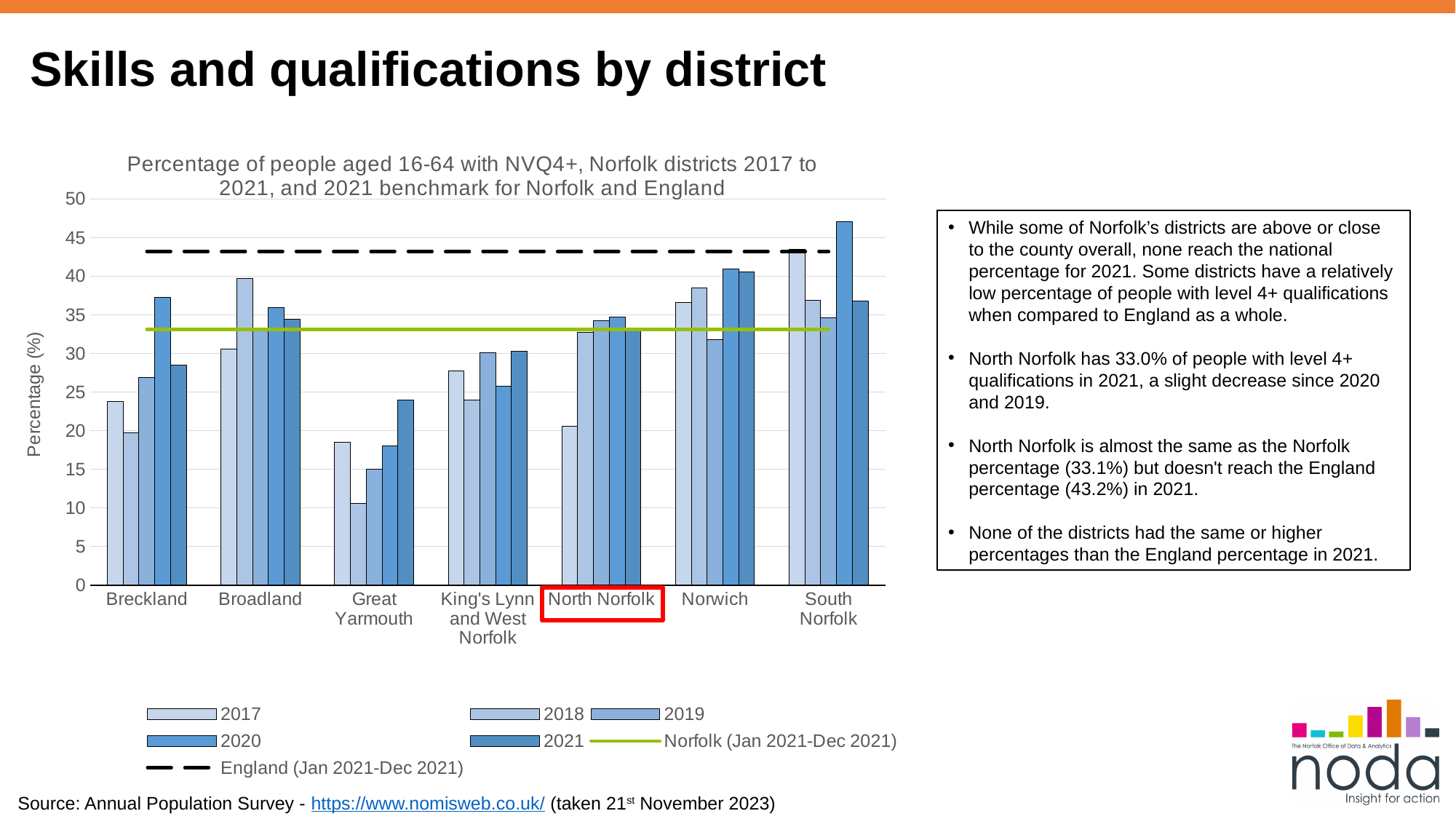
Which district has the highest single bar in the chart? South Norfolk What does the solid green horizontal line in the chart represent? Norfolk (Jan 2021-Dec 2021) Which is larger, the 2018 value for Broadland or the 2018 value for Great Yarmouth? Broadland What kind of chart is shown on the slide? Combination bar and line chart (bars for each year with horizontal benchmark lines for Norfolk and England) What is the England (Jan 2021-Dec 2021) benchmark percentage shown by the dashed line? 43.2% How many districts are shown along the x axis of the chart? 7 Is the 2018 value for Great Yarmouth greater or less than 15? less Which district has the lowest single bar in the chart? Great Yarmouth Is the 2020 value for South Norfolk greater or less than 45? greater Is the 2017 value for Breckland greater or less than 25? less How many entries does the chart's legend list? 7